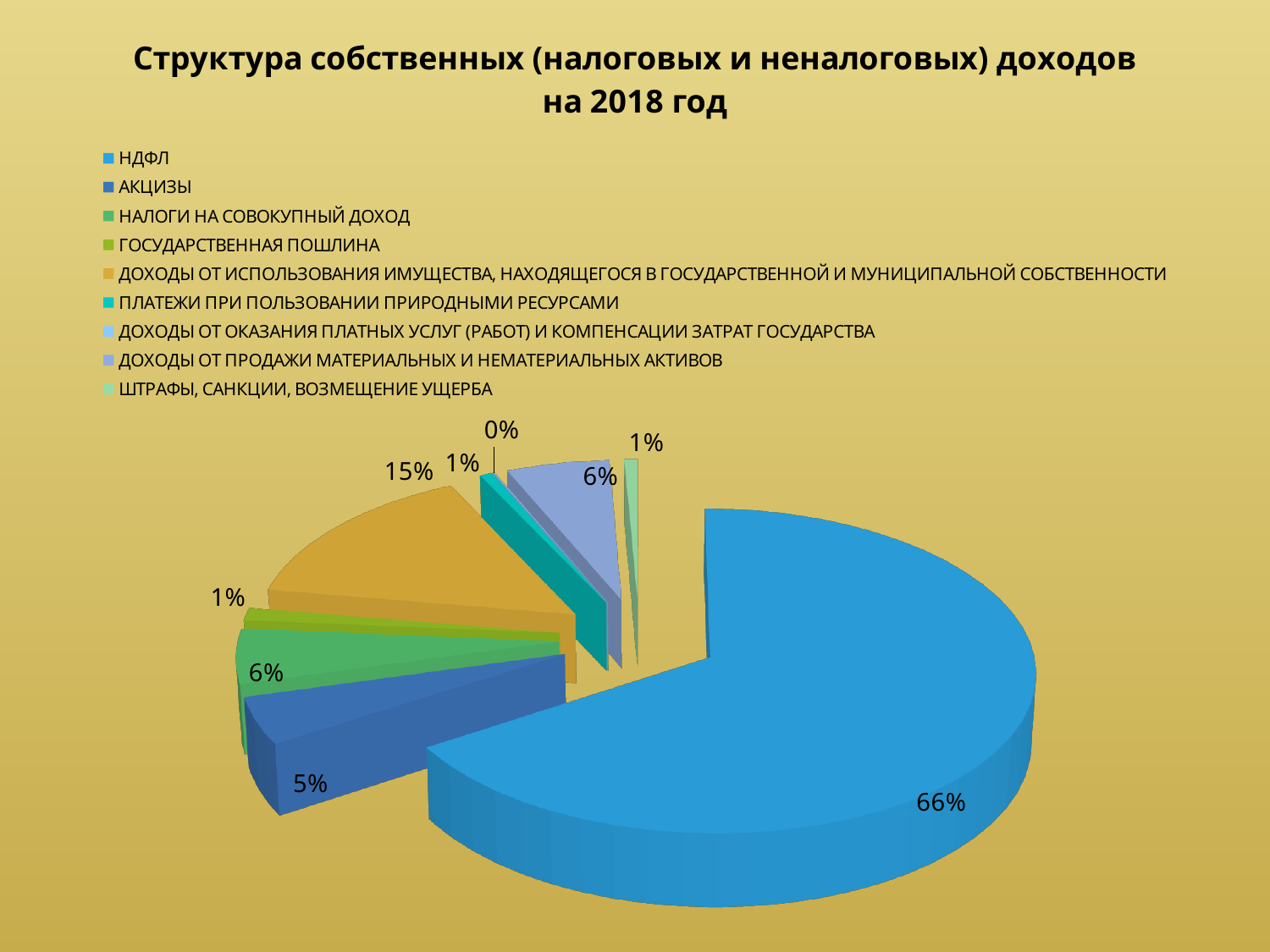
What is the difference in percentage points between НДФЛ and ДОХОДЫ ОТ ИСПОЛЬЗОВАНИЯ ИМУЩЕСТВА, НАХОДЯЩЕГОСЯ В ГОСУДАРСТВЕННОЙ И МУНИЦИПАЛЬНОЙ СОБСТВЕННОСТИ? 51% Which is larger, the share for АКЦИЗЫ or the share for НАЛОГИ НА СОВОКУПНЫЙ ДОХОД? НАЛОГИ НА СОВОКУПНЫЙ ДОХОД What kind of chart is shown on the slide? pie chart What share of the pie does НДФЛ account for? 66% What percentage is shown for АКЦИЗЫ? 5% What percentage is shown for НАЛОГИ НА СОВОКУПНЫЙ ДОХОД? 6% What percentage is shown for ДОХОДЫ ОТ ИСПОЛЬЗОВАНИЯ ИМУЩЕСТВА, НАХОДЯЩЕГОСЯ В ГОСУДАРСТВЕННОЙ И МУНИЦИПАЛЬНОЙ СОБСТВЕННОСТИ? 15% Which category has the smallest share of the pie? ДОХОДЫ ОТ ОКАЗАНИЯ ПЛАТНЫХ УСЛУГ (РАБОТ) И КОМПЕНСАЦИИ ЗАТРАТ ГОСУДАРСТВА What percentage is shown for ДОХОДЫ ОТ ОКАЗАНИЯ ПЛАТНЫХ УСЛУГ (РАБОТ) И КОМПЕНСАЦИИ ЗАТРАТ ГОСУДАРСТВА? 0% What is the title of the chart? Структура собственных (налоговых и неналоговых) доходов на 2018 год Which category has the largest share of the pie? НДФЛ How many categories does the legend list? 9